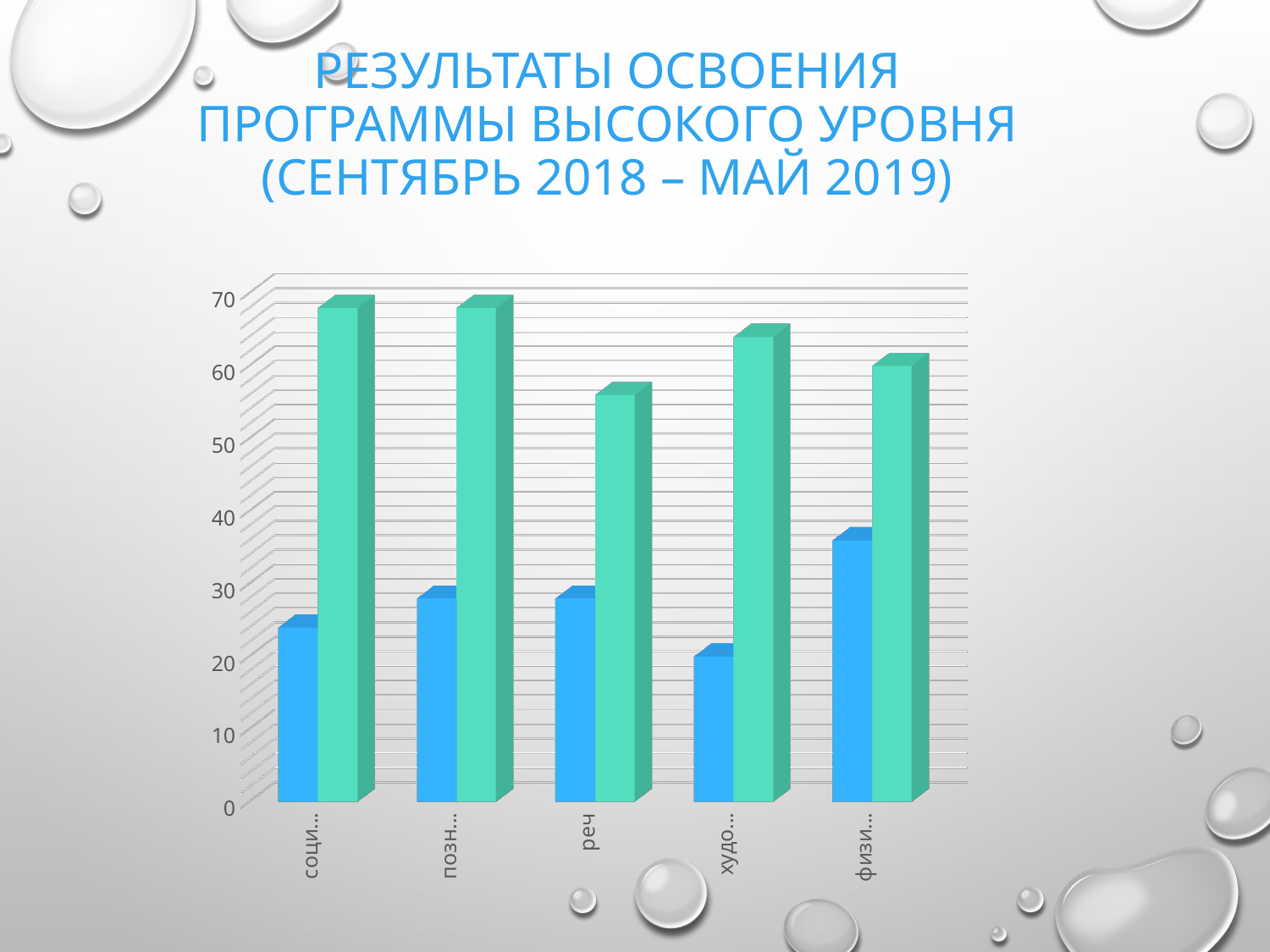
Is the green bar for the first category (соци...) greater or less than 60? greater Is the green bar for the category "реч" greater or less than 50? greater Is the blue bar for the category "реч" greater or less than 20? greater What period is named in the chart's title on the slide? сентябрь 2018 – май 2019 For the category "реч", which bar is taller, the blue one or the green one? the green one Which category has the tallest blue bar? физи... (the fifth category) How many bars are plotted for each category in the chart? 2 What kind of chart is shown on the slide? bar chart Which category has the shortest blue bar? худо... (the fourth category) How many categories are shown along the x axis of the chart? 5